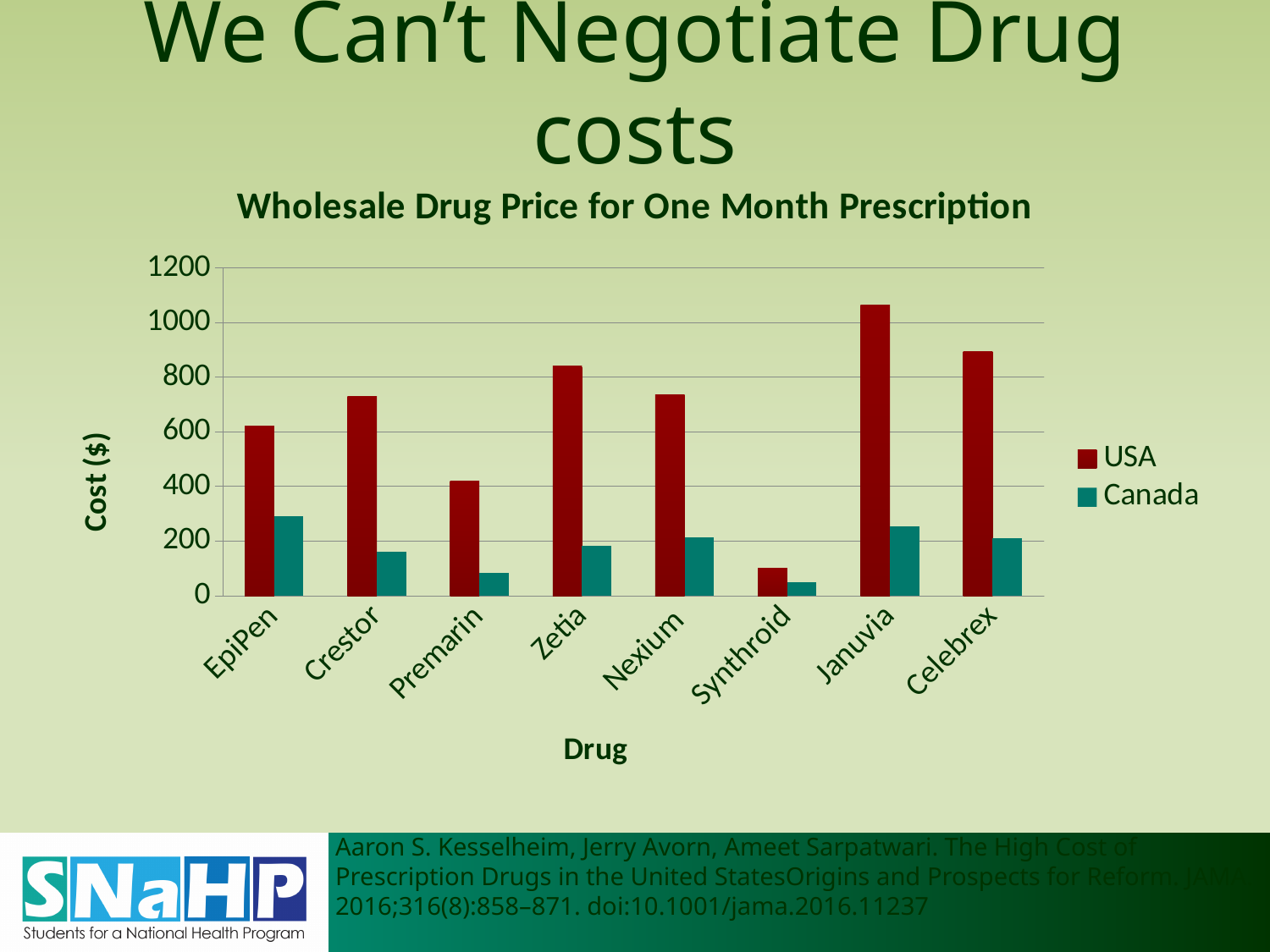
Which drug has the lowest USA wholesale price? Synthroid Which drug has the lowest Canada wholesale price? Synthroid Is the USA value for Zetia greater or less than 800? greater Is the USA value for Synthroid greater or less than 200? less How many drugs are shown on the x axis of the chart? 8 What is the title of the chart? Wholesale Drug Price for One Month Prescription Which is larger, the USA value for Celebrex or the USA value for Nexium? Celebrex What kind of chart is shown on the slide? bar chart Which drug has the highest USA wholesale price? Januvia Is the USA value for Januvia greater or less than 1000? greater How many series does the chart's legend list? 2